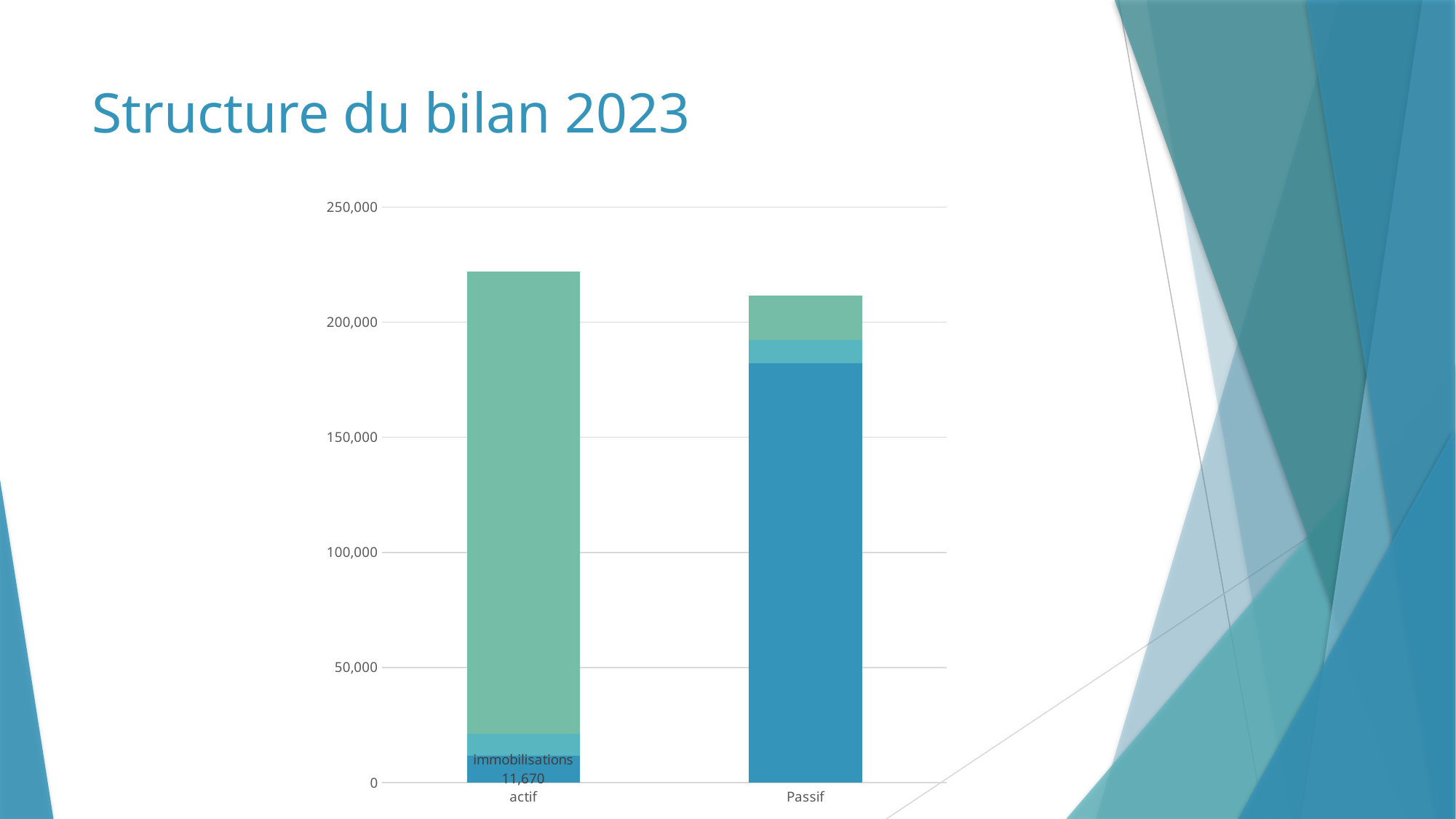
How many stacked segments make up the Passif bar? 3 Which category's bar carries the data label 'immobilisations'? actif What is the title of the slide containing the chart? Structure du bilan 2023 Which is larger, the total of the actif bar or the total of the Passif bar? actif How many categories are shown on the x axis of the chart? 2 Is the total height of the Passif bar greater or less than 200,000? greater Is the bottom (dark blue) segment of the Passif bar greater or less than 150,000? greater What kind of chart is shown on the slide? bar chart Is the total height of the actif bar greater or less than 200,000? greater What is the value of the immobilisations segment in the actif bar? 11,670 Which category has the taller stacked bar, actif or Passif? actif